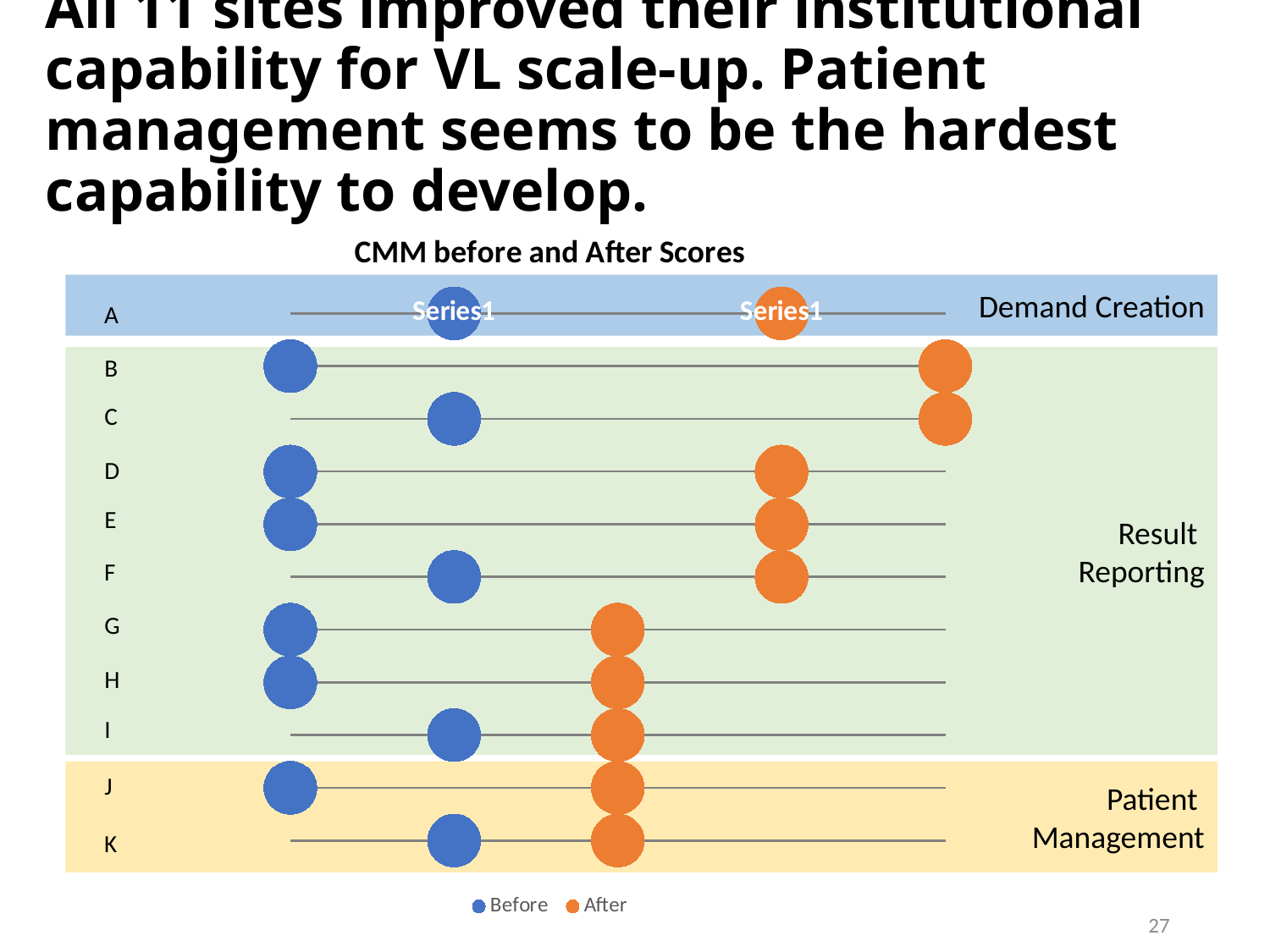
How many sites fall under the Patient Management group? 2 Which site has a larger After value, B or G? B What kind of chart is this? dot plot For site B, which is larger, the Before value or the After value? After How many sites (categories) are plotted on the chart? 11 What are the two series named in the legend? Before and After For site D, which is larger, the Before value or the After value? After How many sites fall under the Result Reporting group? 8 How many series does the legend list? 2 What is the title of the chart? CMM before and After Scores